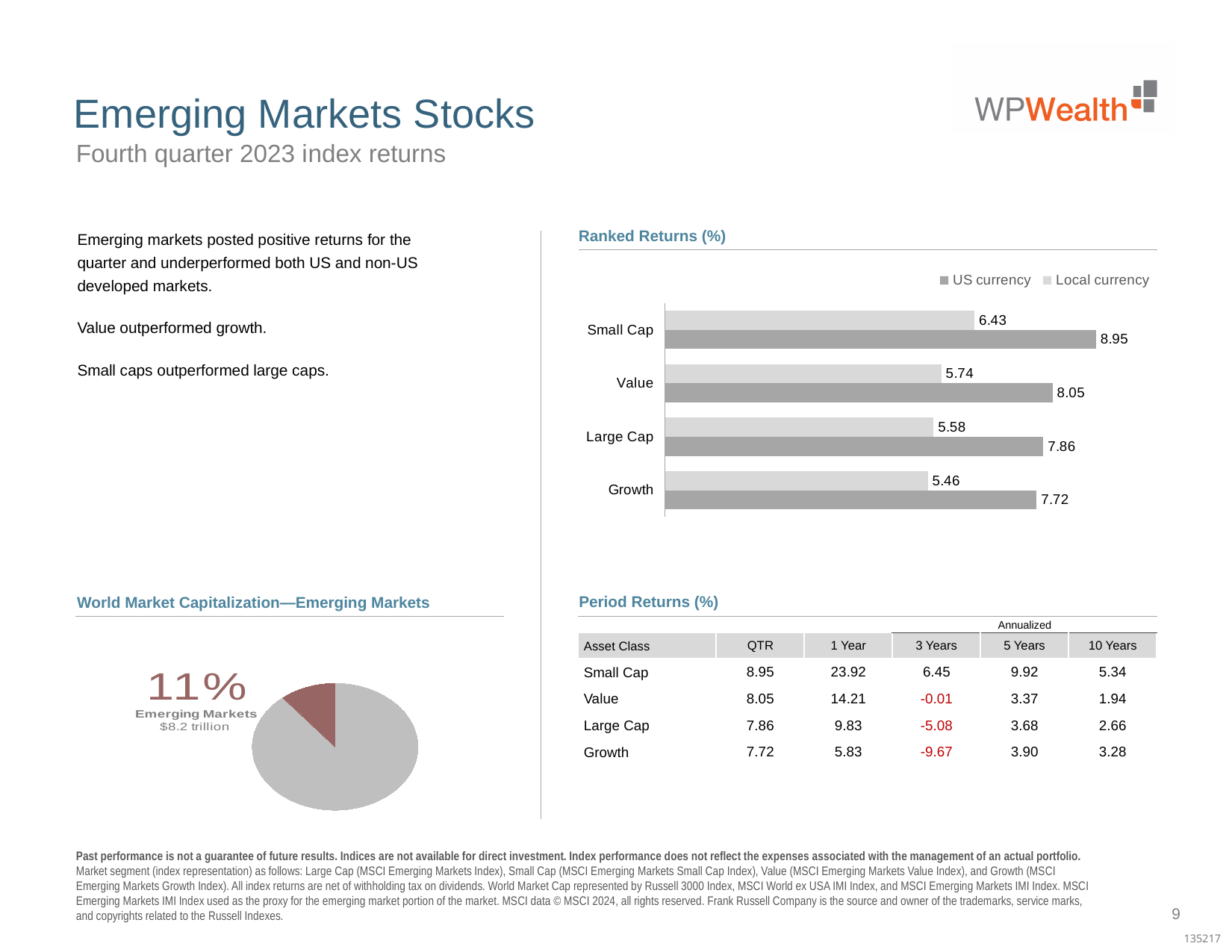
In the Ranked Returns (%) chart, what is the Local currency value for Value? 5.74 In the Ranked Returns (%) chart, what is the US currency value for Small Cap? 8.95 In the Ranked Returns (%) chart, which category has the lowest Local currency value? Growth In the Ranked Returns (%) chart, what is the Local currency value for Growth? 5.46 In the Ranked Returns (%) chart, which category has the highest US currency value? Small Cap In the World Market Capitalization—Emerging Markets chart, what share of the pie do Emerging Markets represent? 11% In the Ranked Returns (%) chart, which is larger for Value: the US currency value or the Local currency value? US currency How many categories are shown in the Ranked Returns (%) chart? 4 What kind of chart is the Ranked Returns (%) chart? Bar chart What kind of chart is the World Market Capitalization—Emerging Markets chart? Pie chart How many series does the legend of the Ranked Returns (%) chart list? 2 In the Ranked Returns (%) chart, what is the difference between the US currency and Local currency values for Large Cap? 2.28